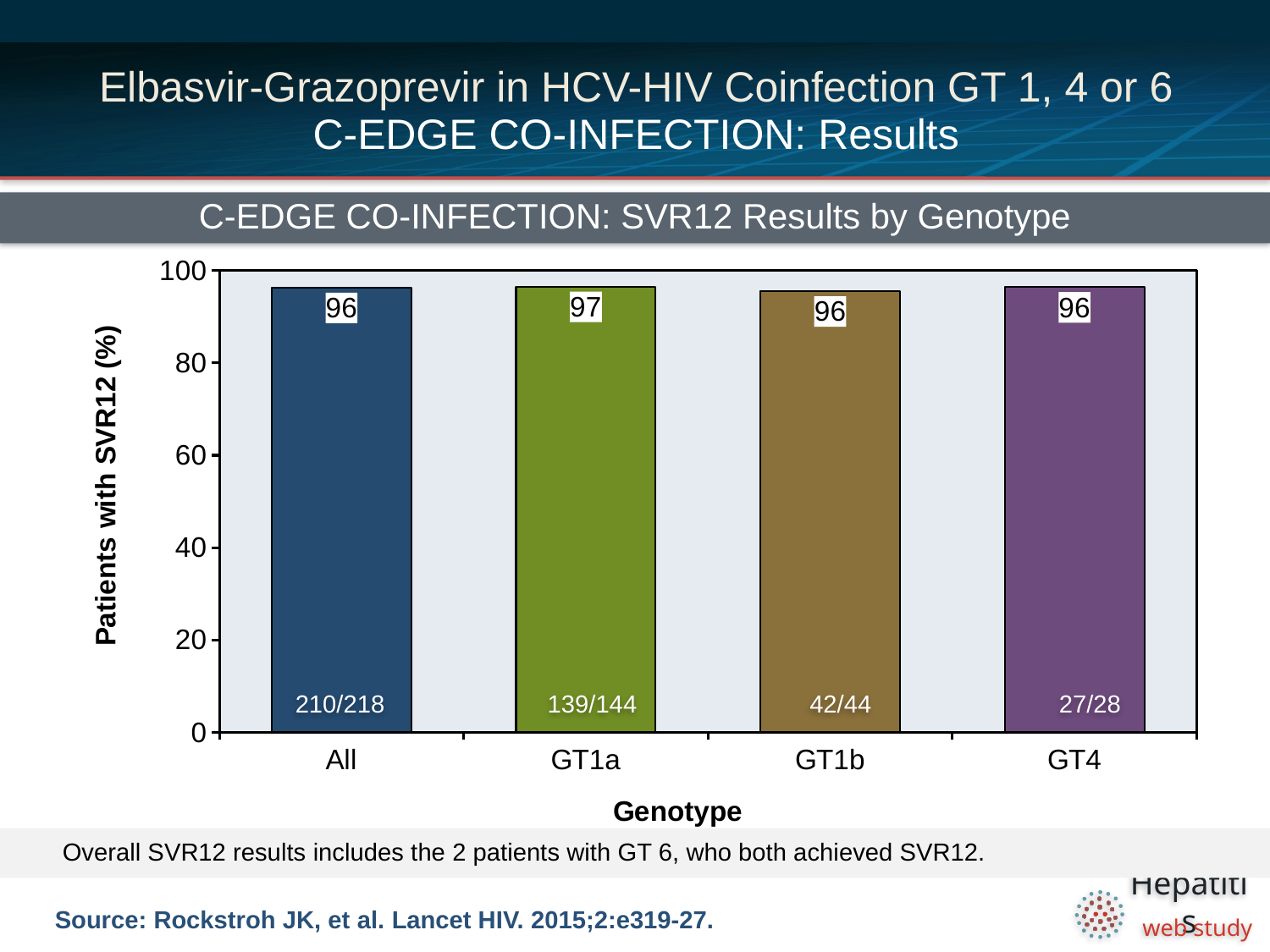
What kind of chart is shown on the slide? Bar chart What is the title of the chart? C-EDGE CO-INFECTION: SVR12 Results by Genotype What fraction of patients is shown inside the GT1b bar? 42/44 What fraction of patients is shown inside the All bar? 210/218 What is the label of the y axis? Patients with SVR12 (%) What is the SVR12 rate for the GT1a group? 97 What is the difference in SVR12 rate between GT1a and GT1b? 1 What is the SVR12 rate for the GT4 group? 96 Which genotype group has the highest SVR12 rate? GT1a Is the SVR12 rate for GT4 greater or less than 80? greater How many genotype categories are shown on the x axis? 4 What is the SVR12 rate for the All group? 96